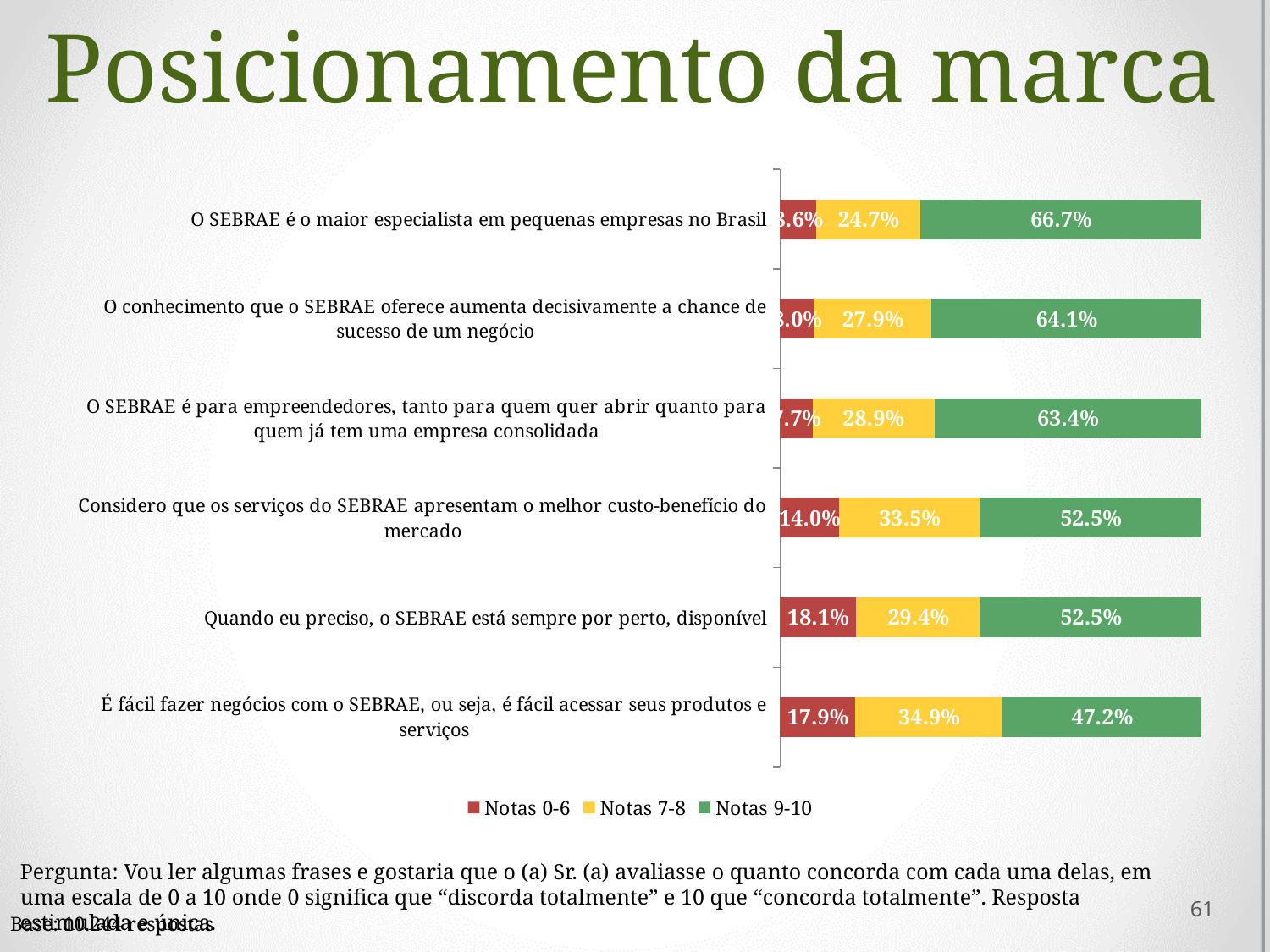
Which is larger: the Notas 7-8 value for "É fácil fazer negócios com o SEBRAE..." or for "Quando eu preciso, o SEBRAE está sempre por perto, disponível"? É fácil fazer negócios com o SEBRAE... (34.9%) Which statement has the lowest Notas 9-10 value? É fácil fazer negócios com o SEBRAE, ou seja, é fácil acessar seus produtos e serviços How many series does the legend list? 3 What is the Notas 9-10 value for "O SEBRAE é o maior especialista em pequenas empresas no Brasil"? 66.7% What is the Notas 0-6 value for "Quando eu preciso, o SEBRAE está sempre por perto, disponível"? 18.1% How many statements (categories) are plotted in the chart? 6 What is the difference between the Notas 9-10 values for "O SEBRAE é o maior especialista em pequenas empresas no Brasil" (66.7%) and "É fácil fazer negócios com o SEBRAE..." (47.2%)? 19.5% Which statement has the highest Notas 9-10 value? O SEBRAE é o maior especialista em pequenas empresas no Brasil What is the Notas 9-10 value for "É fácil fazer negócios com o SEBRAE, ou seja, é fácil acessar seus produtos e serviços"? 47.2% What is the Notas 7-8 value for "Considero que os serviços do SEBRAE apresentam o melhor custo-benefício do mercado"? 33.5% Which colour represents the Notas 9-10 series in the chart? Green What kind of chart is shown on the slide? Stacked bar chart